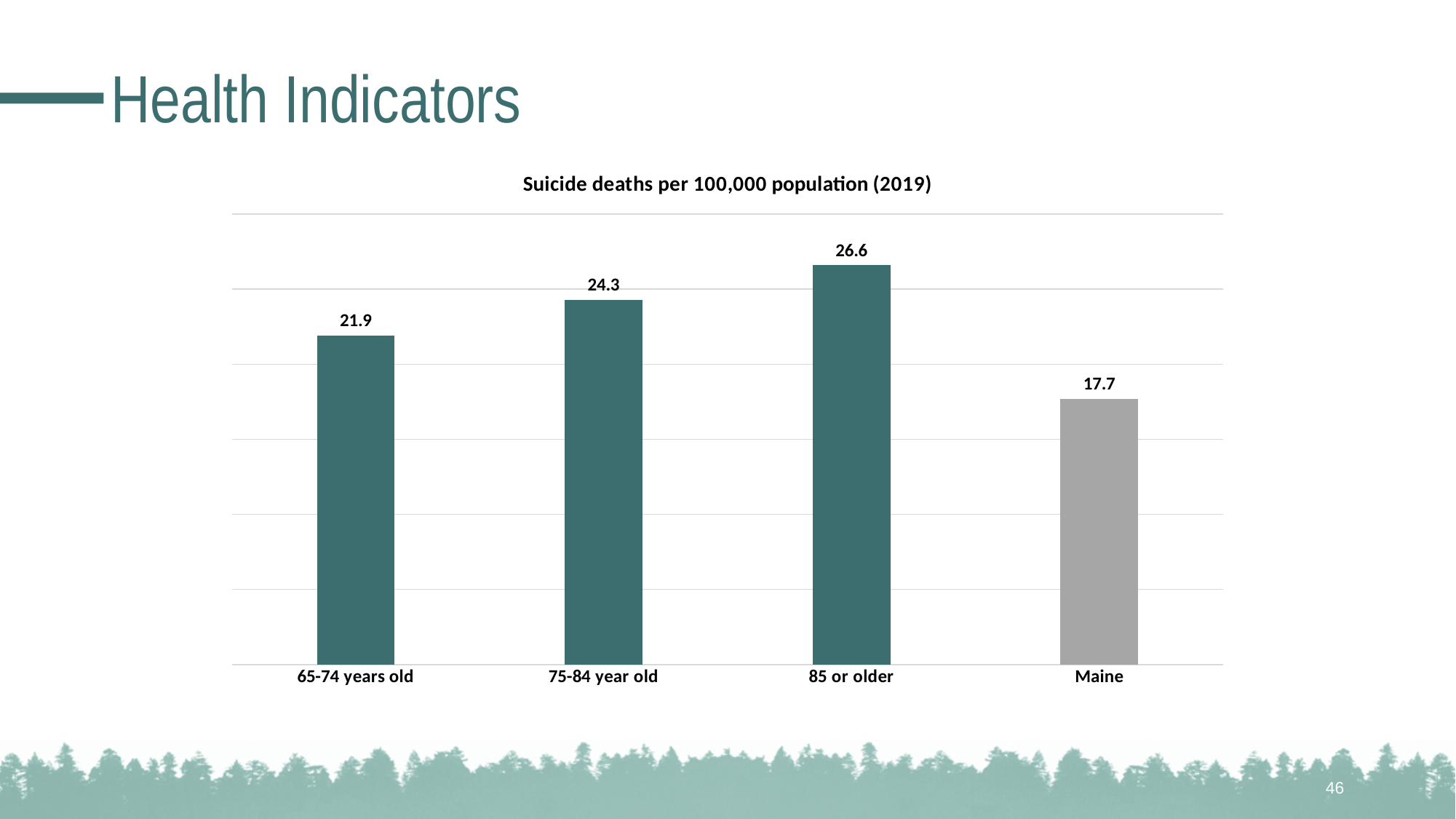
What is the suicide death rate per 100,000 population for the 85 or older group? 26.6 Which category has the highest suicide death rate? 85 or older What kind of chart is shown on the slide? Bar chart What is the difference between the suicide death rate for 85 or older and for Maine? 8.9 What is the suicide death rate per 100,000 population for the 75-84 year old group? 24.3 What is the title of the chart? Suicide deaths per 100,000 population (2019) How many categories are shown in the chart? 4 What is the suicide death rate per 100,000 population for the 65-74 years old group? 21.9 Which is larger, the suicide death rate for 65-74 years old or for Maine? 65-74 years old What is the suicide death rate per 100,000 population for Maine? 17.7 What is the difference between the suicide death rate for 75-84 year old and 65-74 years old? 2.4 Which category has the lowest suicide death rate? Maine